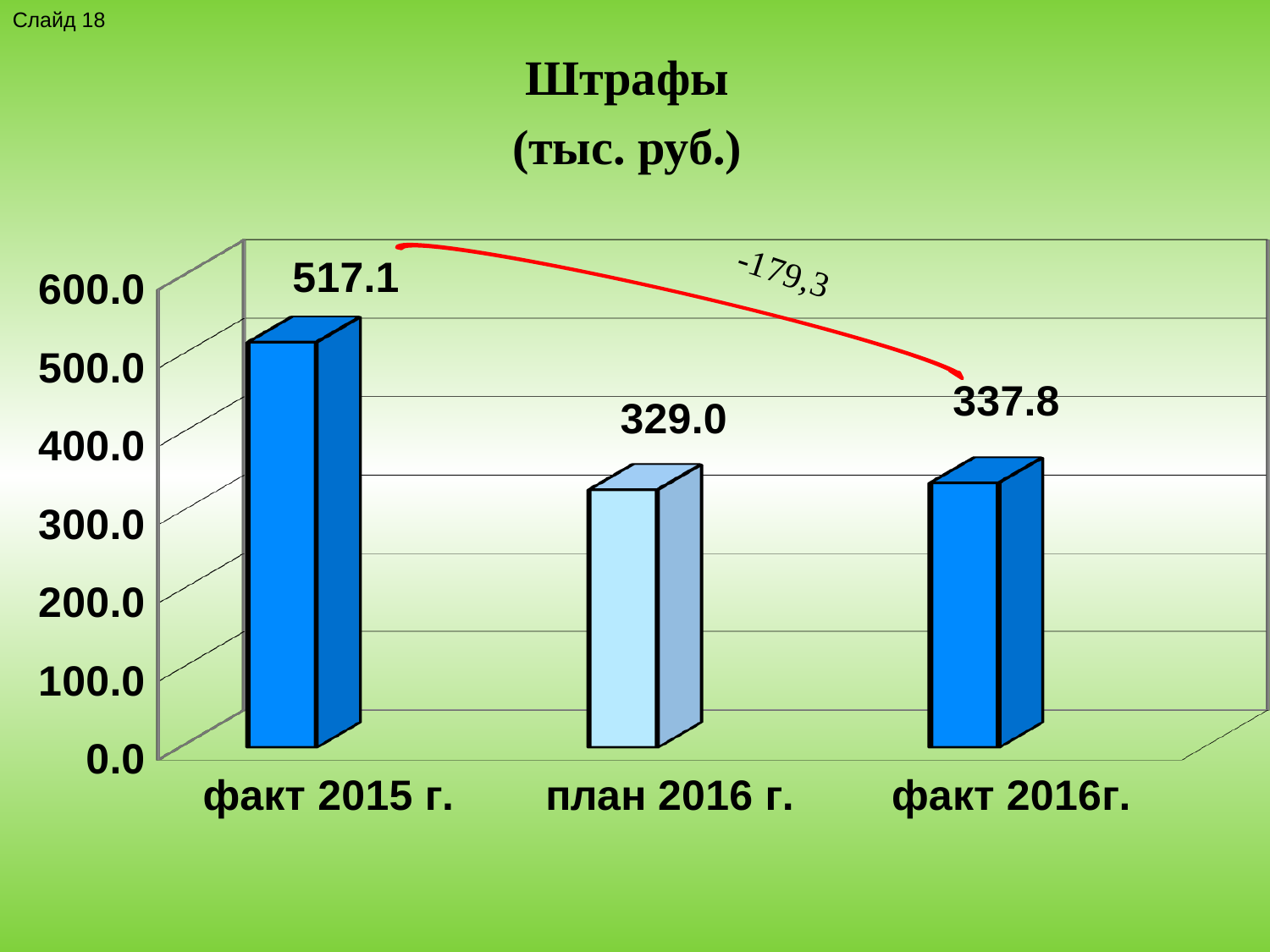
What kind of chart is shown on the slide? bar chart Which category has the lowest value? план 2016 г. What is the difference between the values for факт 2015 г. and факт 2016г.? 179.3 What is the difference between the values for факт 2016г. and план 2016 г.? 8.8 Which is larger, the value for факт 2015 г. or the value for план 2016 г.? факт 2015 г. What is the value for факт 2015 г.? 517.1 Which category has the highest value? факт 2015 г. What is the value for факт 2016г.? 337.8 What is the value for план 2016 г.? 329.0 How many categories are shown on the chart? 3 What is the title of the chart? Штрафы (тыс. руб.) Is the value for факт 2015 г. greater or less than 500.0? greater